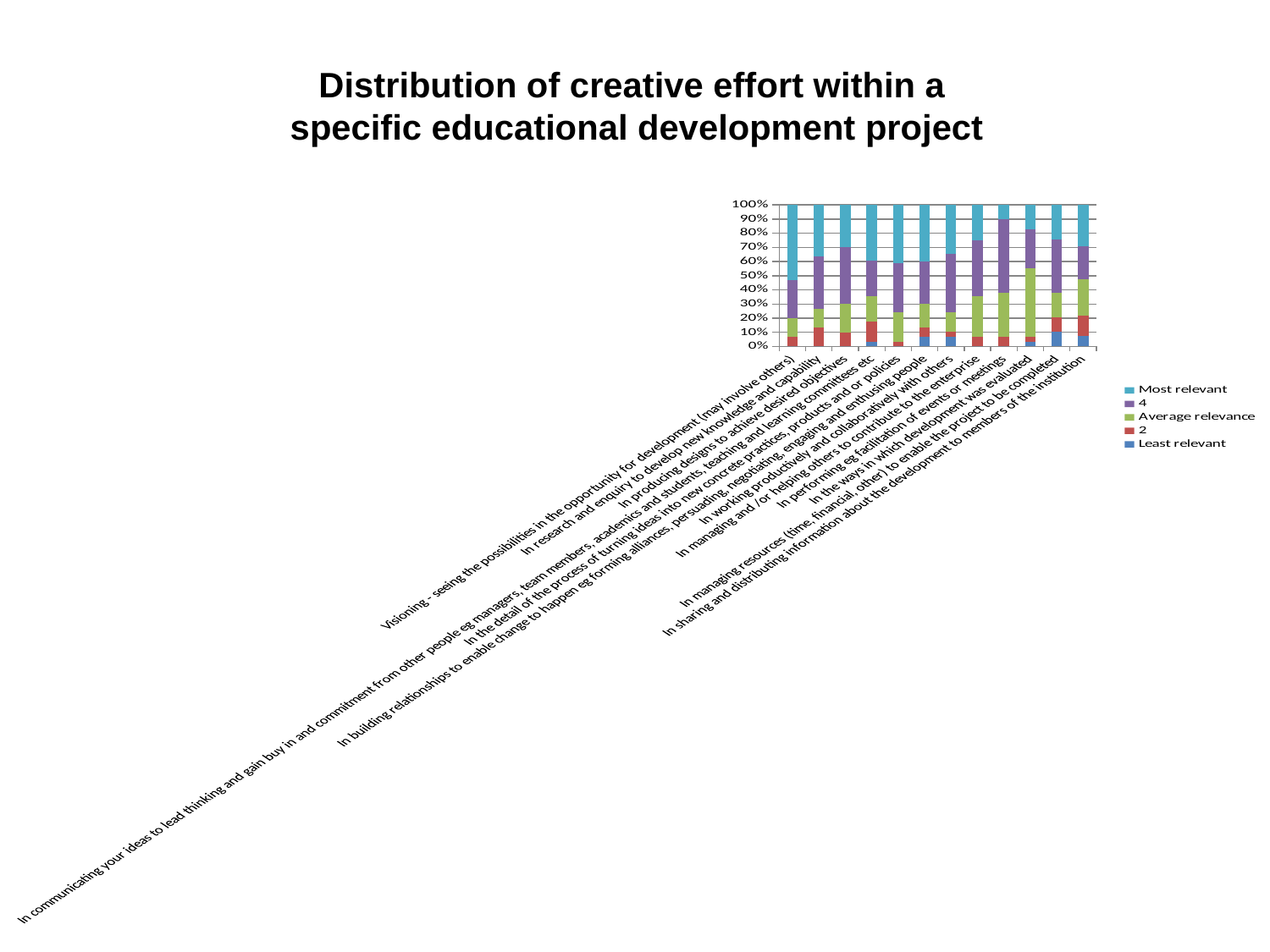
Is the 'Most relevant' segment of the 'Visioning - seeing the possibilities in the opportunity for development (may involve others)' bar greater or less than 40%? greater Which colour represents the 'Most relevant' series in the chart? Light blue How many categories (bars) are plotted in the chart? 12 What is the total height of each stacked bar in the chart? 100% Is the 'Most relevant' segment of the 'In research and enquiry to develop new knowledge and capability' bar greater or less than 20%? greater How many series does the legend list? 5 What are the entries listed in the chart's legend? Most relevant, 4, Average relevance, 2, Least relevant Which has the larger 'Most relevant' share: 'Visioning - seeing the possibilities in the opportunity for development (may involve others)' or 'In performing eg facilitation of events or meetings'? Visioning - seeing the possibilities in the opportunity for development (may involve others) What kind of chart is shown on the slide? Stacked bar chart Is the 'Most relevant' segment of the 'In performing eg facilitation of events or meetings' bar greater or less than 30%? less Which category has the largest 'Most relevant' share? Visioning - seeing the possibilities in the opportunity for development (may involve others)